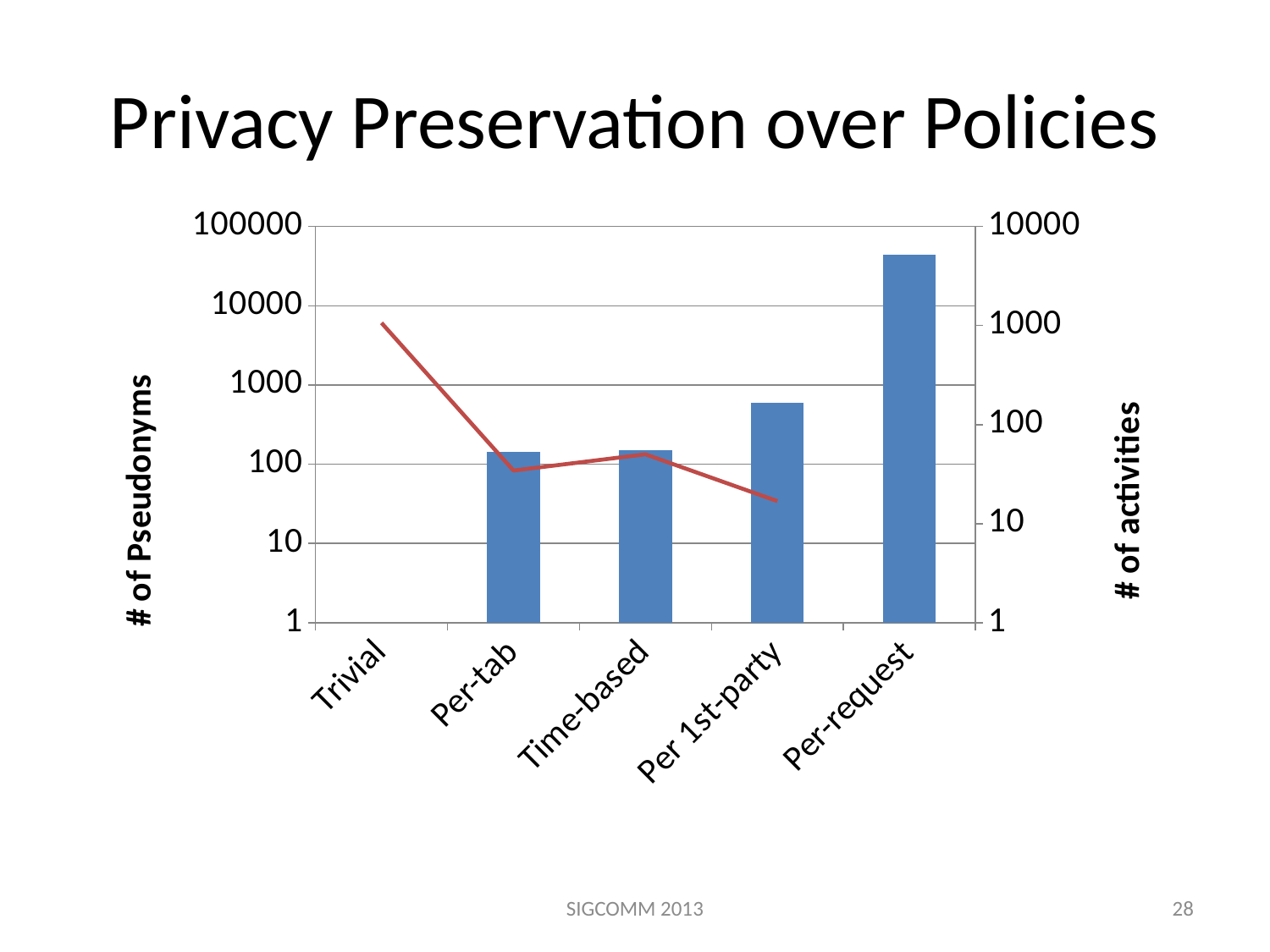
Which has the taller # of Pseudonyms bar, Per 1st-party or Per-request? Per-request What is the title of the right vertical axis? # of activities Is the # of Pseudonyms bar for Per 1st-party greater or less than 1000? less What kind of chart is shown on the slide? A combined bar and line chart Is the # of activities value for Per 1st-party greater or less than 100? less What is the title of the left vertical axis? # of Pseudonyms Is the # of Pseudonyms bar for Per 1st-party greater or less than 100? greater Which policy has the tallest bar for # of Pseudonyms? Per-request Which policy has the highest point on the # of activities line? Trivial How many policy categories are listed on the x axis? 5 Does the # of activities line generally rise or fall from Trivial to Per 1st-party? fall